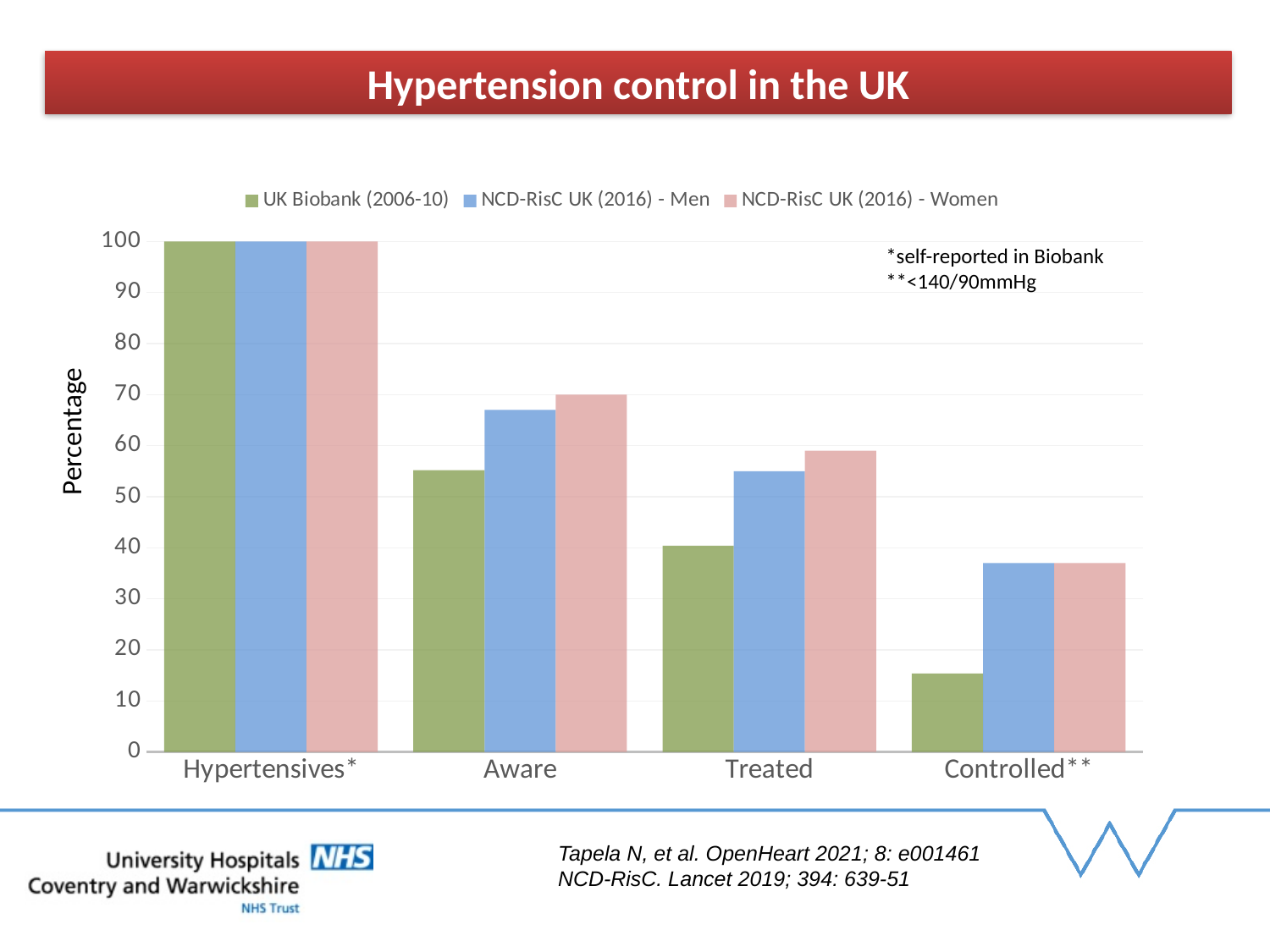
How many series does the legend list? 3 Is the value for UK Biobank (2006-10) in the Controlled** category greater or less than 20? less Do the UK Biobank (2006-10) values rise or fall moving from Hypertensives* to Controlled** along the x axis? fall What is the value for UK Biobank (2006-10) in the Hypertensives* category? 100 Which category has the highest value for the NCD-RisC UK (2016) - Women series? Hypertensives* What is the label on the vertical axis of the chart? Percentage In the Aware category, which is larger: UK Biobank (2006-10) or NCD-RisC UK (2016) - Men? NCD-RisC UK (2016) - Men How many categories are shown on the x axis? 4 What kind of chart is shown on the slide? Bar chart Which category has the lowest value for the UK Biobank (2006-10) series? Controlled** Is the value for UK Biobank (2006-10) in the Aware category greater or less than 50? greater Is the value for NCD-RisC UK (2016) - Men in the Controlled** category greater or less than 30? greater